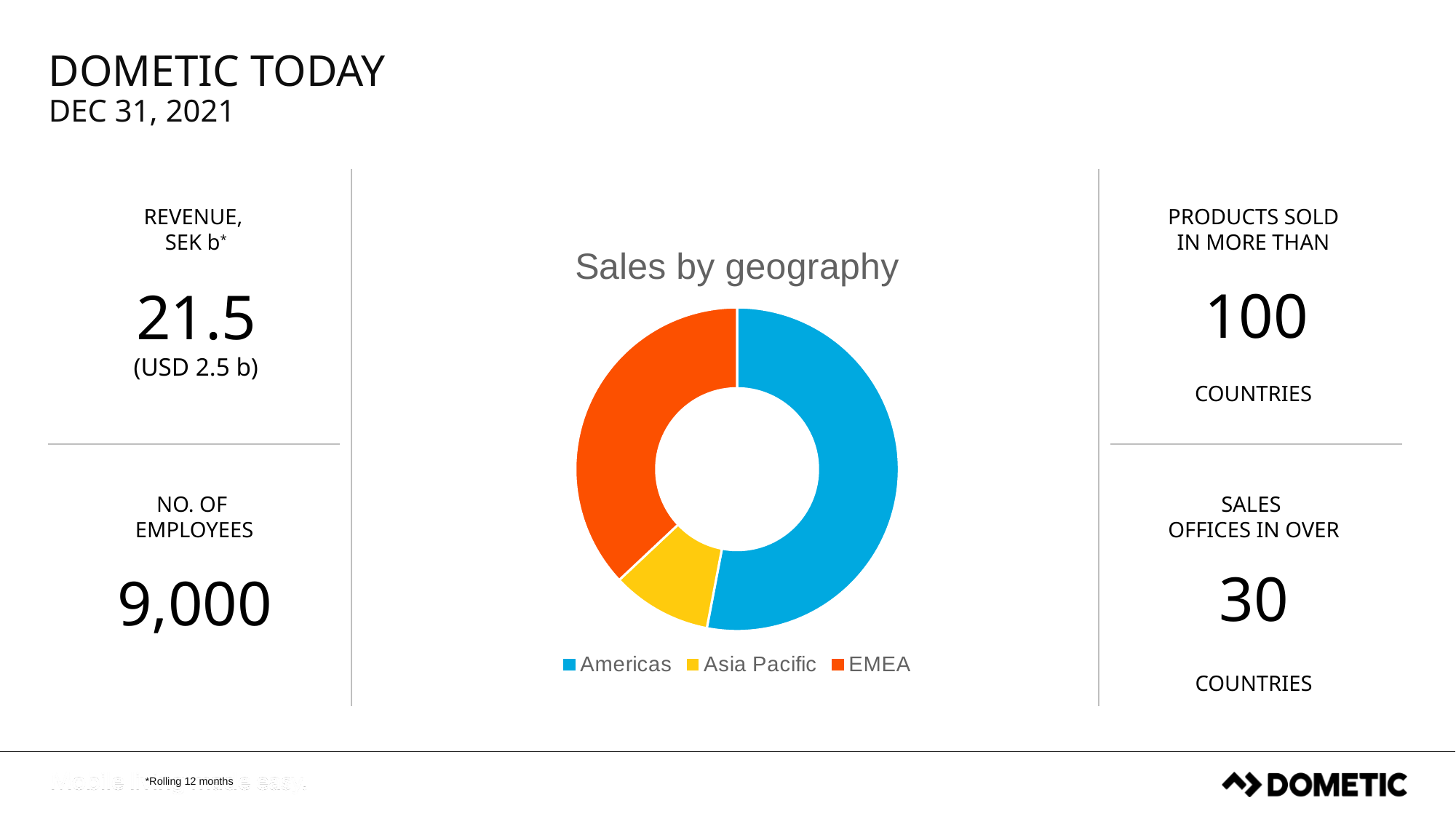
What kind of chart is the "Sales by geography" chart? Doughnut chart Which region has the largest share of sales in the "Sales by geography" chart? Americas Which region is shown in yellow in the "Sales by geography" chart? Asia Pacific How many entries does the legend of the "Sales by geography" chart list? 3 What is the title of the chart on the slide? Sales by geography In the "Sales by geography" chart, which has a larger share of sales, EMEA or Asia Pacific? EMEA How many regions does the "Sales by geography" chart show? 3 Which region has the smallest share of sales in the "Sales by geography" chart? Asia Pacific Which colour represents EMEA in the "Sales by geography" chart? Orange In the "Sales by geography" chart, which has a larger share of sales, Americas or EMEA? Americas